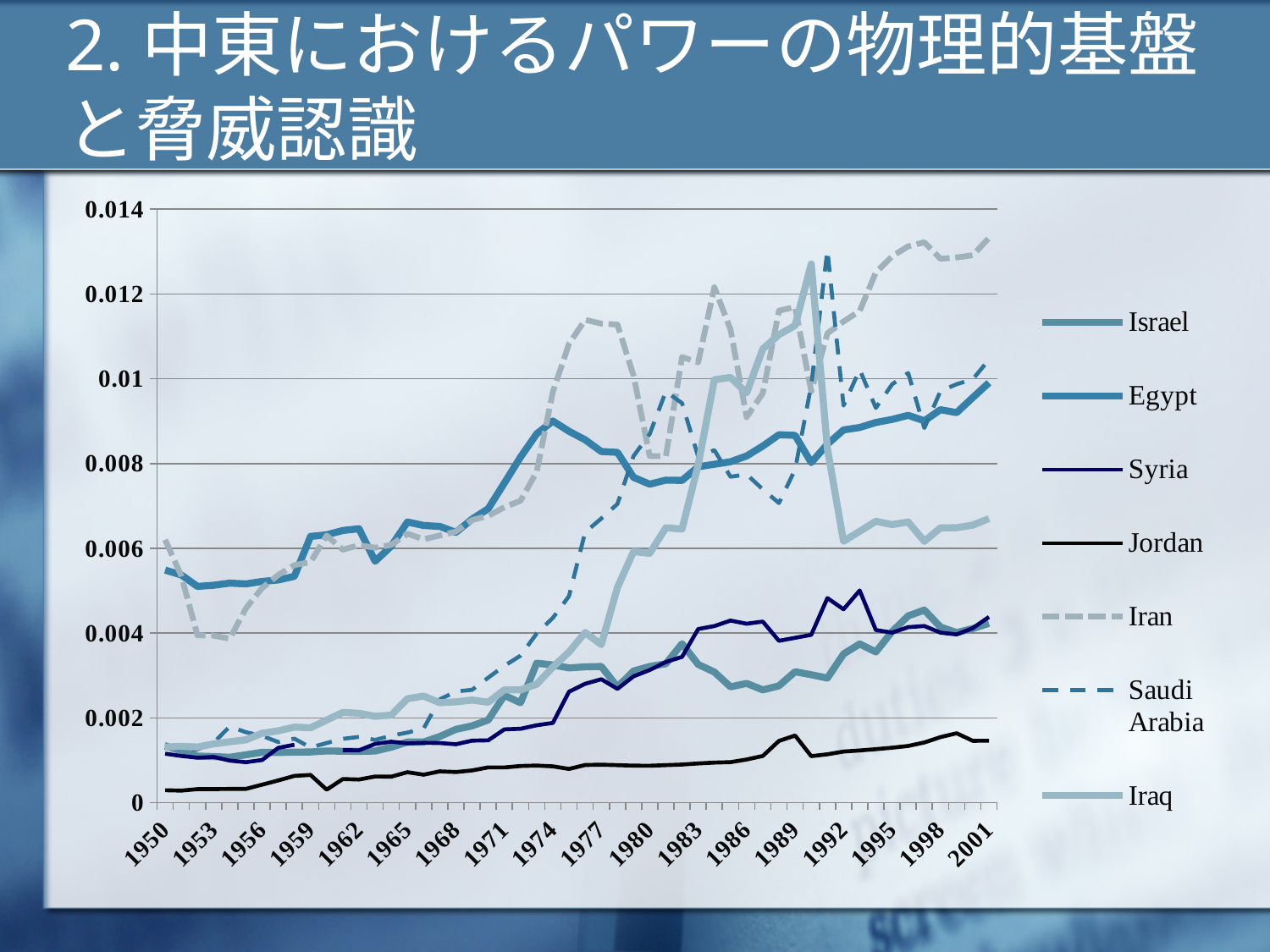
What kind of chart is shown on the slide? line chart Is the value for Iraq in 2001 greater or less than 0.008? less In 2001, which is larger, the value for Egypt or the value for Syria? Egypt Is the value for Egypt in 1950 greater or less than 0.004? greater Which two series are drawn with dashed lines? Iran and Saudi Arabia What is the first year labelled on the x axis? 1950 Is the value for Iran in 2001 greater or less than 0.012? greater Does the value for Jordan generally rise or fall from 1950 to 2001? rise Which series has the lowest value in 2001? Jordan How many series does the legend list? 7 Which series has the highest value in 2001? Iran